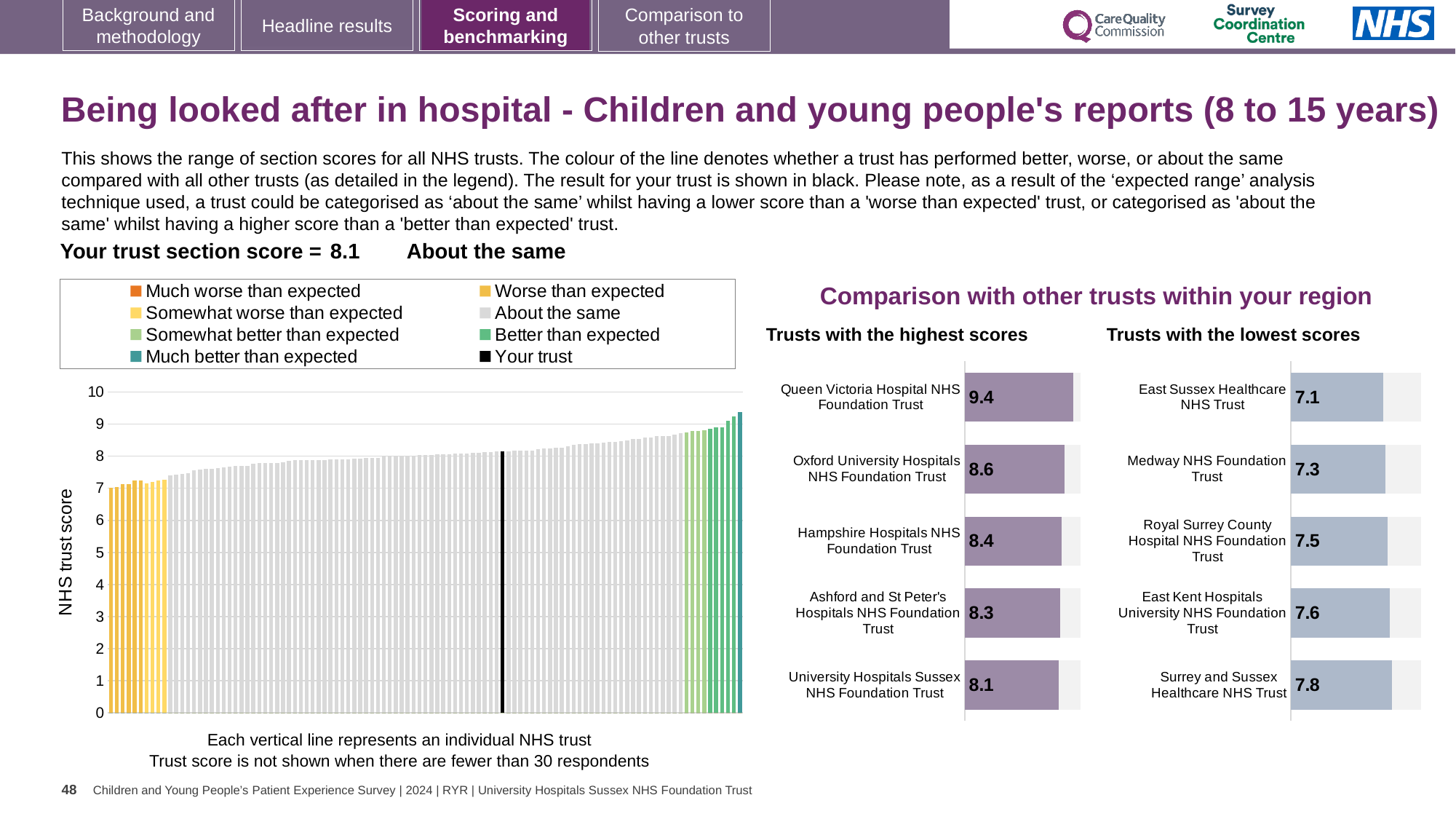
How many entries does the legend above the large chart on the left list? 8 In the large chart on the left, do the trust scores rise or fall from left to right? Rise What is the y-axis label of the large chart on the left? NHS trust score In the 'Trusts with the highest scores' chart, what is the difference between the scores of Queen Victoria Hospital NHS Foundation Trust and Oxford University Hospitals NHS Foundation Trust? 0.8 In the 'Trusts with the lowest scores' chart, what is the score for Medway NHS Foundation Trust? 7.3 In the 'Trusts with the highest scores' chart, what is the score for Queen Victoria Hospital NHS Foundation Trust? 9.4 What kind of chart is the large chart on the left showing NHS trust scores? Bar chart In the 'Trusts with the lowest scores' chart, what is the difference between the scores of East Kent Hospitals University NHS Foundation Trust and East Sussex Healthcare NHS Trust? 0.5 In the 'Trusts with the highest scores' chart, which trust has the lowest score shown? University Hospitals Sussex NHS Foundation Trust In the 'Trusts with the lowest scores' chart, which trust has the lowest score? East Sussex Healthcare NHS Trust In the 'Trusts with the lowest scores' chart, which has the higher score: Royal Surrey County Hospital NHS Foundation Trust or Surrey and Sussex Healthcare NHS Trust? Surrey and Sussex Healthcare NHS Trust How many trusts are shown in the 'Trusts with the highest scores' chart? 5